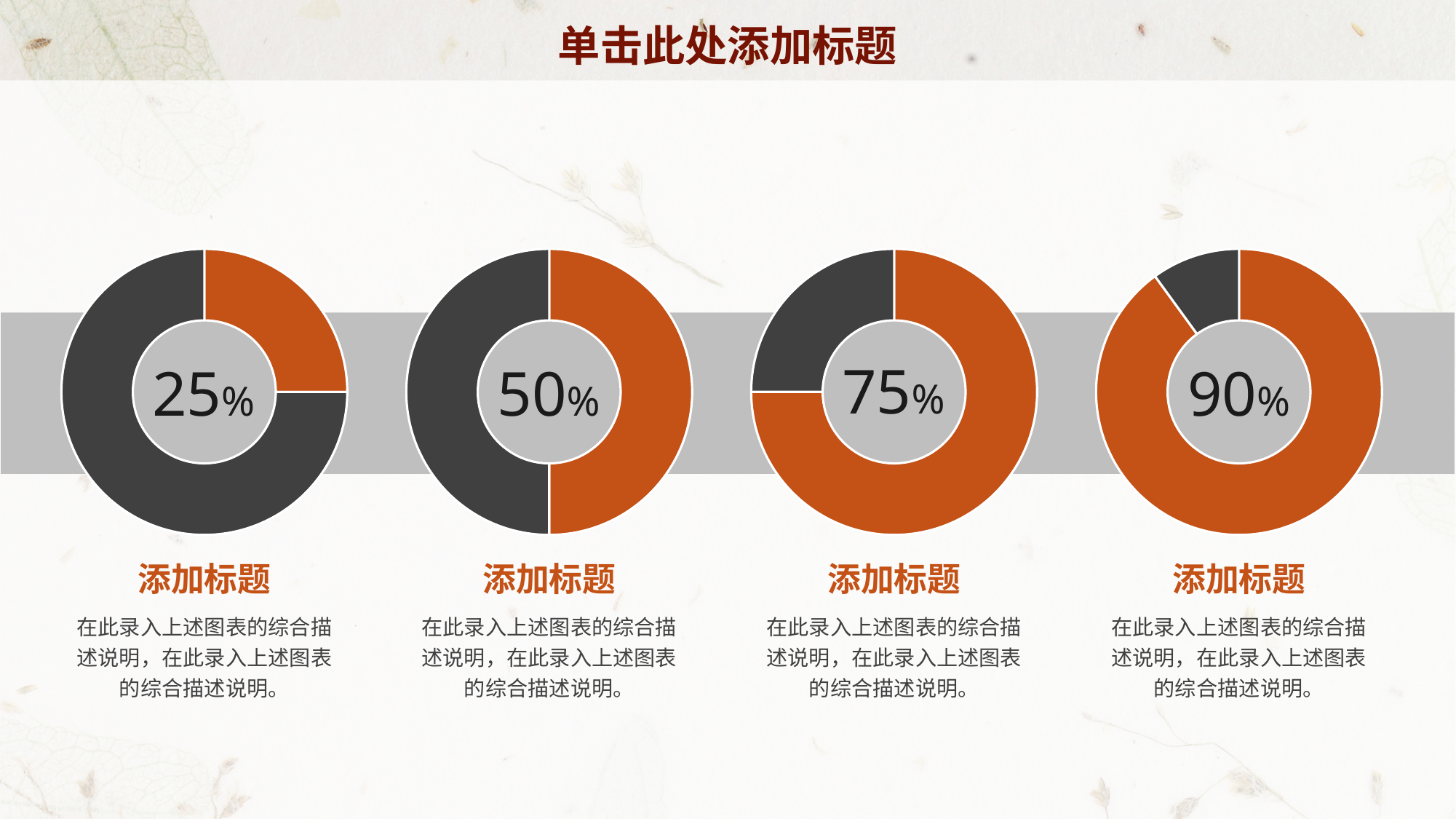
Which doughnut chart shows the lowest percentage, by position on the slide? The leftmost chart (25%) What kind of chart is used for each of the four charts on the slide? Doughnut chart Which doughnut chart shows the highest percentage, by position on the slide? The rightmost chart (90%) How many doughnut charts are on the slide? 4 What percentage is shown in the centre of the leftmost doughnut chart? 25% In the leftmost doughnut chart, what share of the ring does the orange segment represent? 25% What is the difference between the percentage in the rightmost doughnut chart and the percentage in the leftmost doughnut chart? 65% What percentage is shown in the centre of the third doughnut chart from the left? 75% Which is larger: the percentage in the second doughnut chart from the left or the percentage in the third doughnut chart from the left? The third chart (75%) What two colours are used for the segments of the doughnut charts? Orange and dark grey What percentage is shown in the centre of the second doughnut chart from the left? 50% What percentage is shown in the centre of the rightmost doughnut chart? 90%